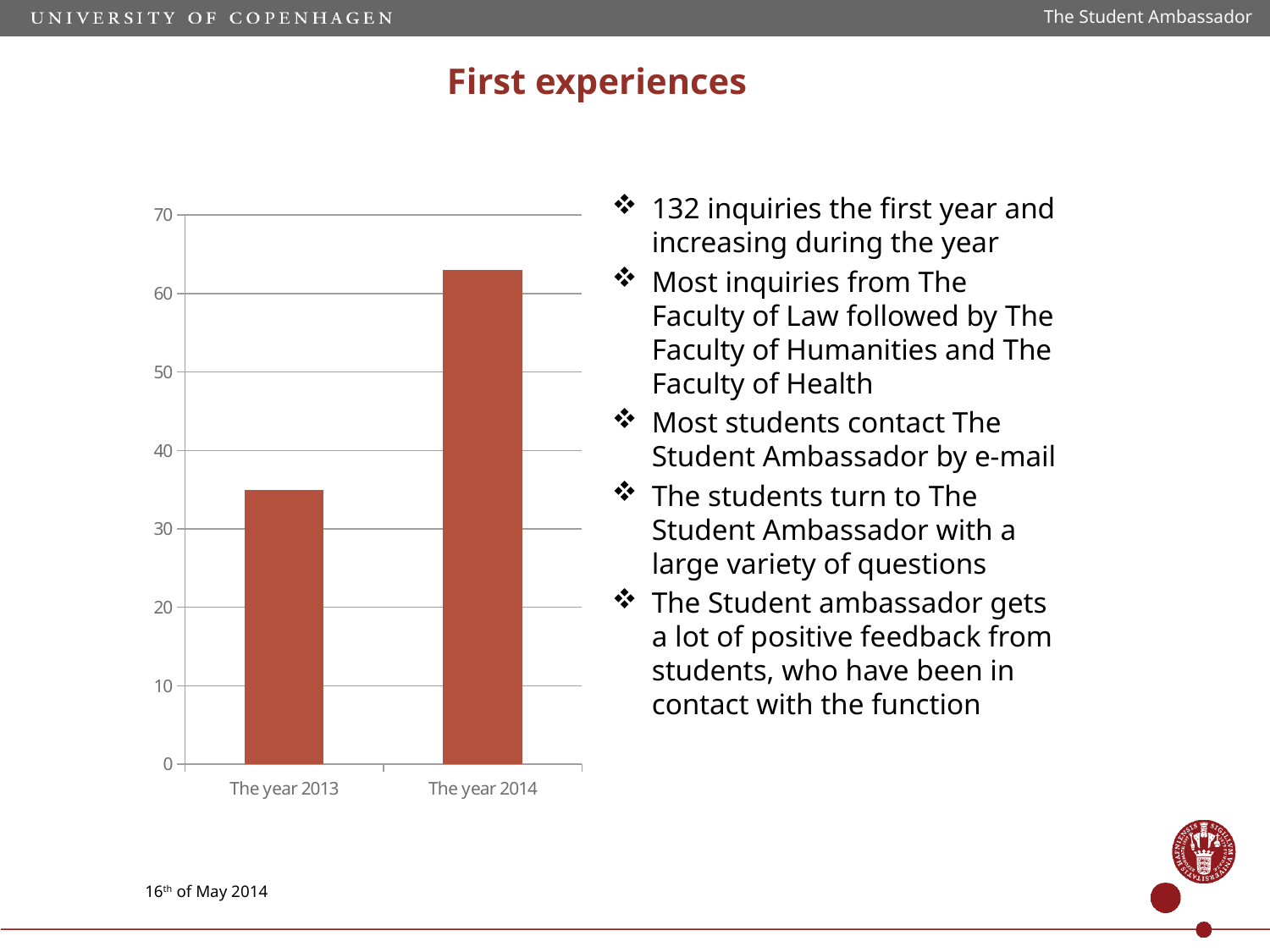
Is the value for The year 2014 greater or less than 60? greater Which category has the lowest bar in the chart? The year 2013 What kind of chart is shown on the slide? bar chart Is the value for The year 2013 greater or less than 30? greater Is the value for The year 2013 greater or less than 40? less Which is larger, the value for The year 2013 or the value for The year 2014? The year 2014 What colour are the bars in the chart? red-brown Which category has the highest bar in the chart? The year 2014 Do the values rise or fall from The year 2013 to The year 2014? rise What is the highest value shown on the vertical axis of the chart? 70 How many categories are plotted on the x axis of the chart? 2